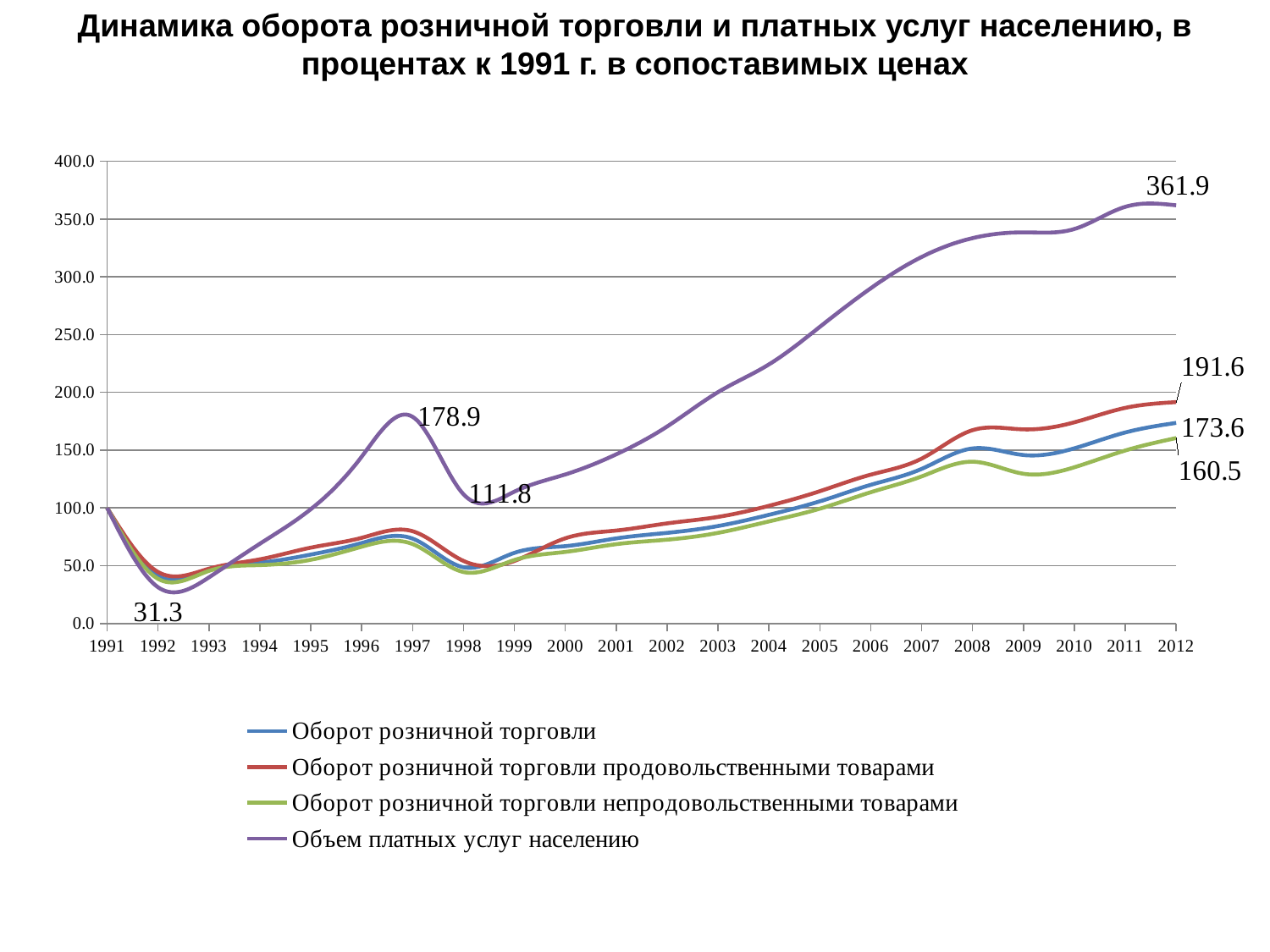
Which series has the highest value in 2012? Объем платных услуг населению What is the difference between the 1997 and 1998 values for Объем платных услуг населению? 67.1 What is the value for Оборот розничной торговли продовольственными товарами in 2012? 191.6 What is the value for Объем платных услуг населению in 1997? 178.9 What is the value for Объем платных услуг населению in 1992? 31.3 What is the value for Оборот розничной торговли непродовольственными товарами in 2012? 160.5 What is the difference between Объем платных услуг населению and Оборот розничной торговли продовольственными товарами in 2012? 170.3 Which series has the lowest value in 2012? Оборот розничной торговли непродовольственными товарами What is the value for Объем платных услуг населению in 2012? 361.9 How many series does the legend list? 4 Is the value for Оборот розничной торговли in 2005 greater or less than 150? less What kind of chart is shown on the slide? line chart